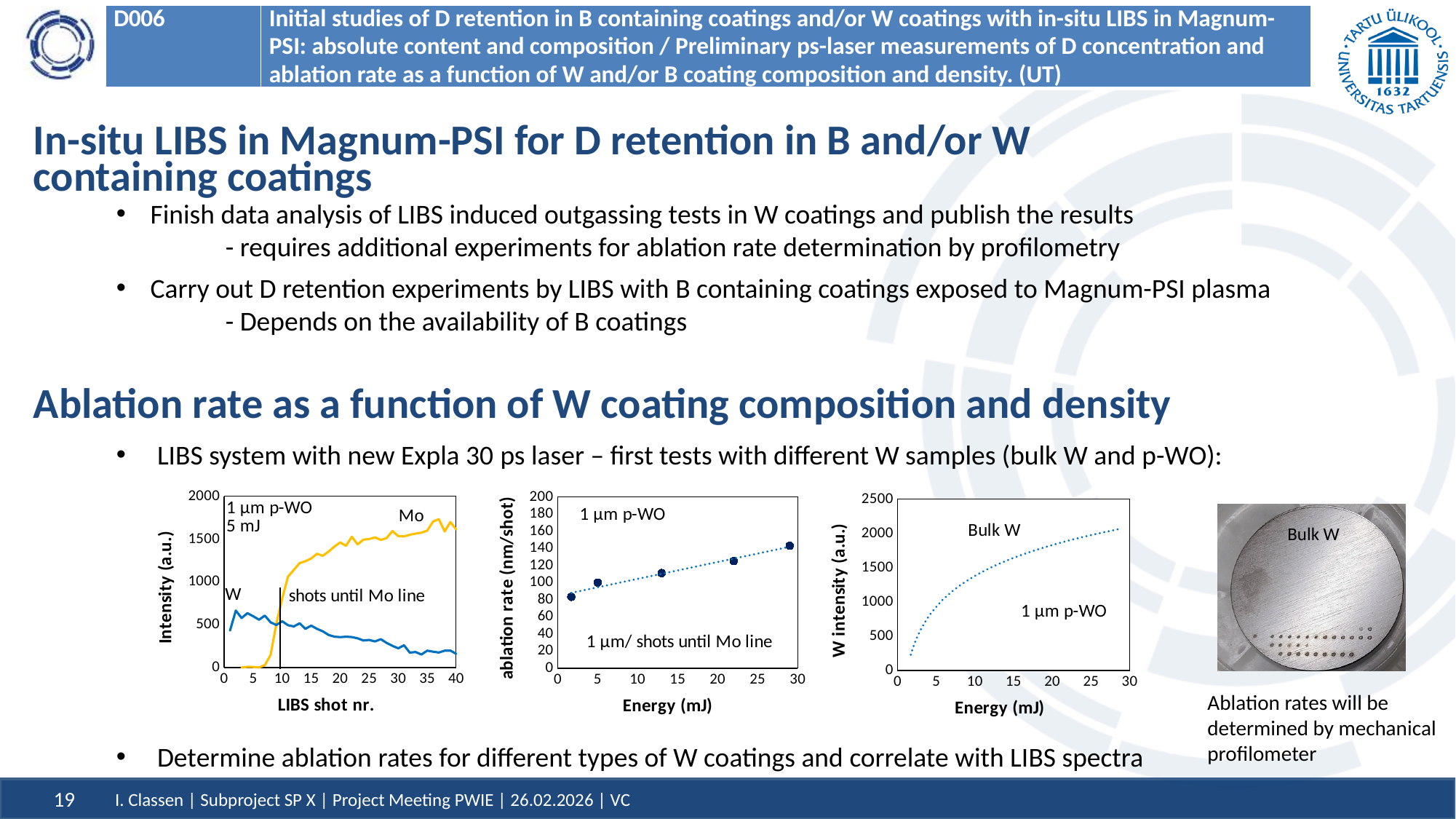
In the left chart (Intensity vs LIBS shot nr.), at shot 40, which line has the higher intensity, Mo or W? Mo In the left chart (Intensity vs LIBS shot nr.), does the Mo line rise or fall as the shot number increases? rise In the middle chart (ablation rate vs Energy), does the ablation rate rise or fall as energy increases? rise In the right chart (W intensity vs Energy), is the Bulk W intensity at 10 mJ greater or less than 1000? greater In the middle chart (ablation rate vs Energy), is the ablation rate at the lowest energy point greater or less than 100 nm/shot? less What is the x-axis label of the left chart? LIBS shot nr. In the right chart (W intensity vs Energy), does the Bulk W intensity rise or fall as energy increases? rise In the middle chart (ablation rate vs Energy), is the ablation rate at the highest energy point greater or less than 120 nm/shot? greater In the left chart (Intensity vs LIBS shot nr.), what kind of chart is it? line chart In the left chart (Intensity vs LIBS shot nr.), at shot 5, which line has the higher intensity, Mo or W? W In the middle chart (ablation rate vs Energy), how many data points are plotted? 5